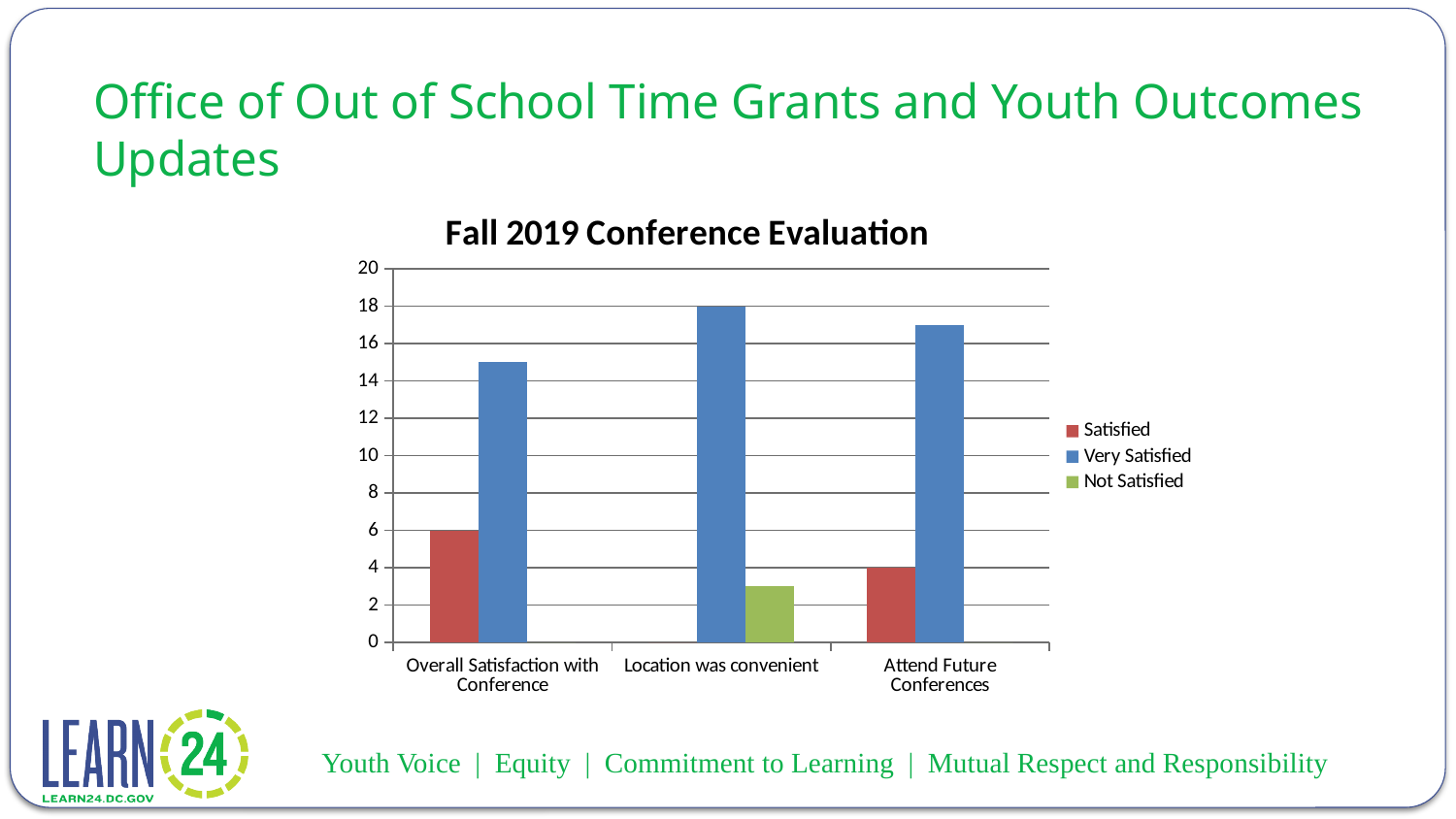
Which category has the highest Very Satisfied value? Location was convenient Is the Very Satisfied value for Attend Future Conferences greater or less than 16? greater How many series does the legend list? 3 Is the Very Satisfied value for Overall Satisfaction with Conference greater or less than 14? greater What is the title of the chart? Fall 2019 Conference Evaluation What is the Very Satisfied value for Location was convenient? 18 What is the Satisfied value for Overall Satisfaction with Conference? 6 Is the Not Satisfied value for Location was convenient greater or less than 4? less What is the Satisfied value for Attend Future Conferences? 4 What kind of chart is shown on the slide? bar chart What is the difference between the Satisfied values for Overall Satisfaction with Conference and Attend Future Conferences? 2 How many categories are shown on the x axis? 3